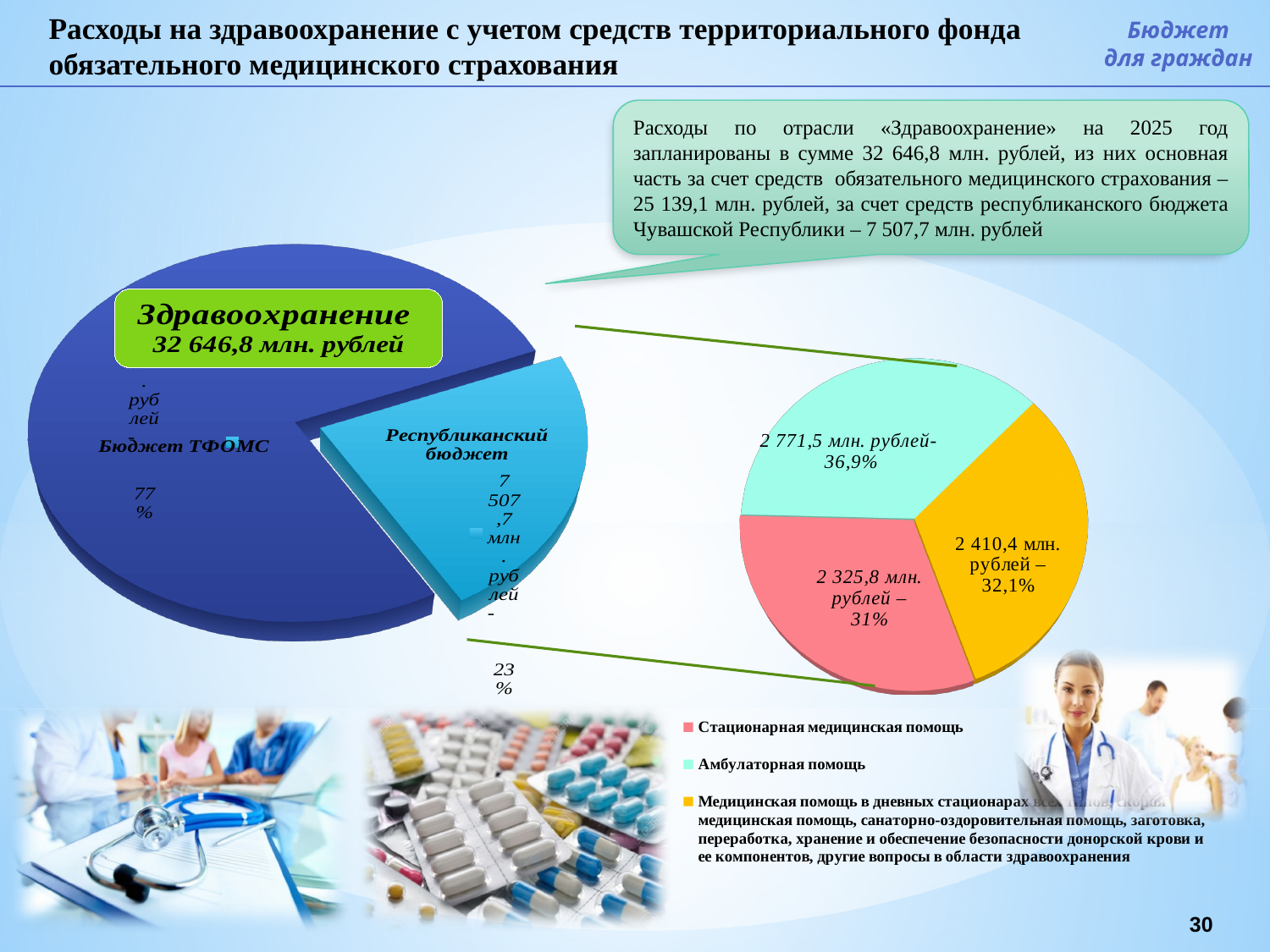
In the right pie chart, which category has the largest share? Амбулаторная помощь In the left pie chart, what share does Республиканский бюджет have? 23% In the left pie chart, what value is shown for Республиканский бюджет? 7 507,7 млн. рублей In the left pie chart, which slice is larger: Бюджет ТФОМС or Республиканский бюджет? Бюджет ТФОМС In the right pie chart, what value is shown for Амбулаторная помощь? 2 771,5 млн. рублей In the right pie chart, what colour is the slice for Амбулаторная помощь? Light cyan What kind of chart is the left chart on the slide? Pie chart In the right pie chart, what share does Стационарная медицинская помощь have? 31% How many slices does the right pie chart have? 3 In the left pie chart, what share does Бюджет ТФОМС have? 77% What kind of chart is the right chart on the slide? Pie chart In the right pie chart, which category has the smallest share? Стационарная медицинская помощь